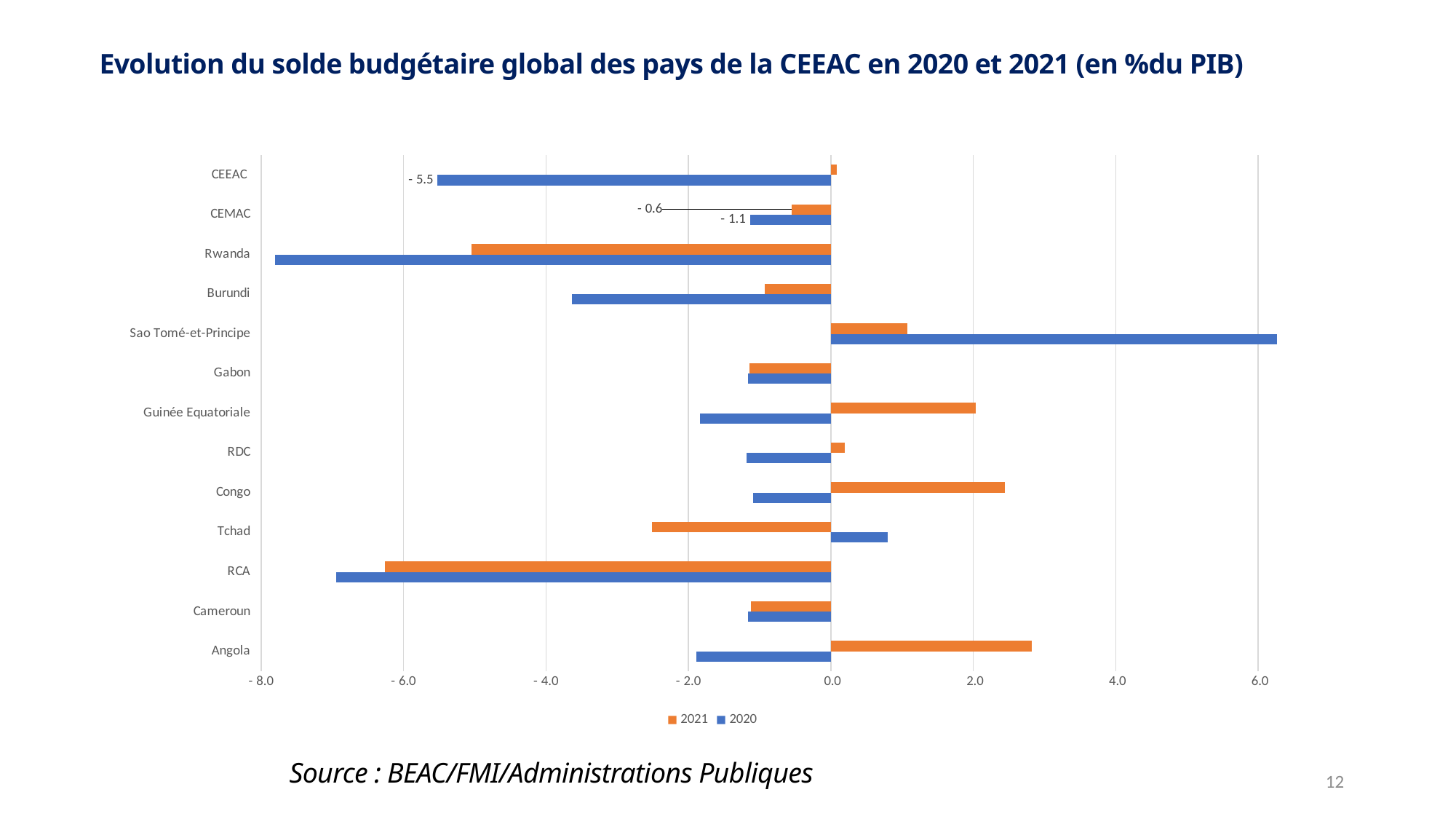
What is the 2020 value for CEMAC? -1.1 Is the 2020 value for RCA greater or less than -6.0? less How many series does the legend list? 2 Which category has the highest 2020 value? Sao Tomé-et-Principe Which colour represents the 2021 series? orange What type of chart is shown on the slide? bar chart What is the difference between the 2021 and 2020 values for CEMAC? 0.5 Which category has the lowest 2020 value? Rwanda Which category has the highest 2021 value? Angola What is the 2020 value for CEEAC? -5.5 How many categories are plotted on the chart? 13 What is the 2021 value for CEMAC? -0.6